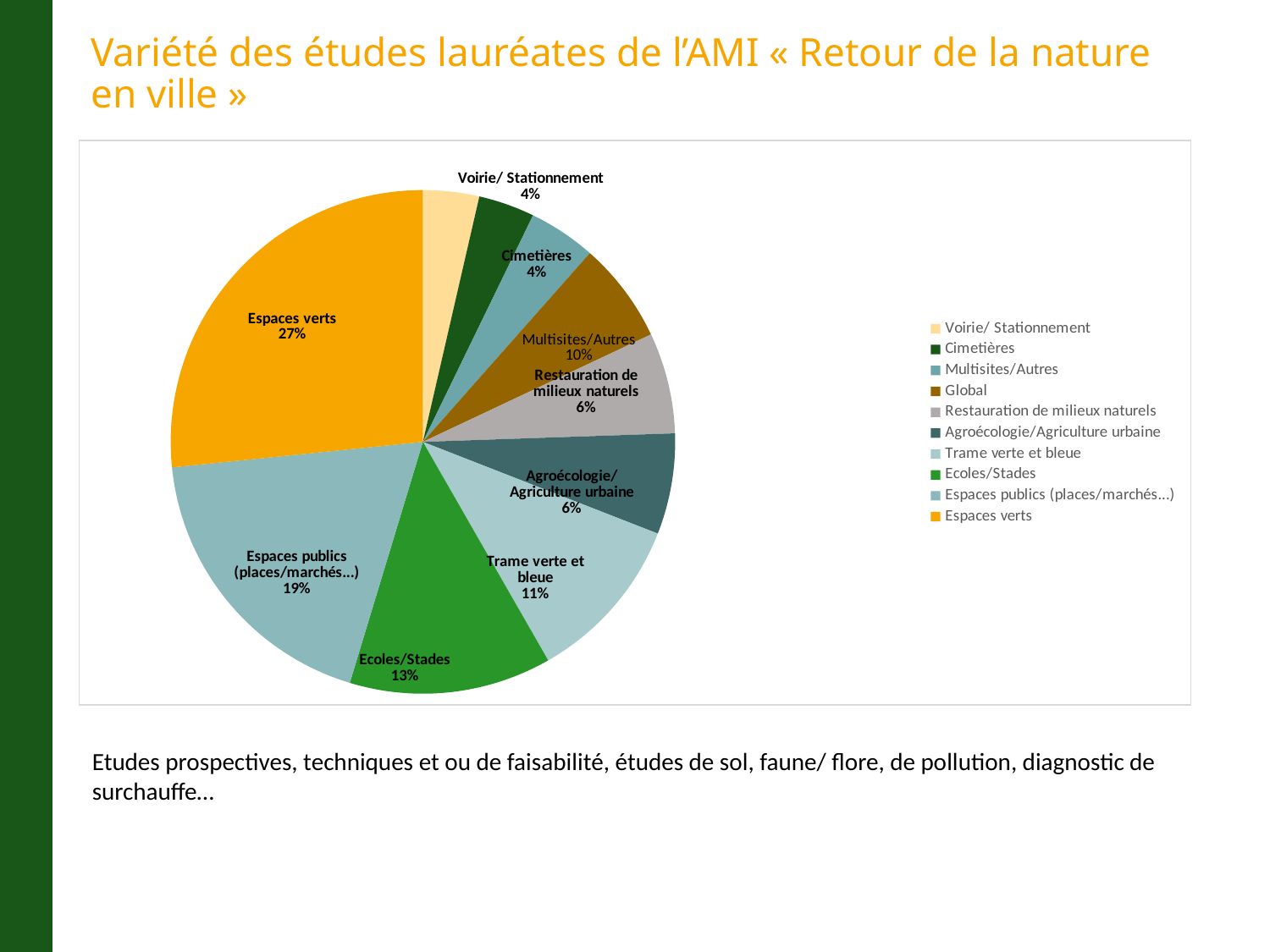
What percentage is shown for "Trame verte et bleue"? 11% What share of the pie does "Espaces verts" represent? 27% How many categories does the legend list? 10 What percentage is shown for "Cimetières"? 4% Which category has the largest share of the pie? Espaces verts What percentage is shown for "Espaces publics (places/marchés…)"? 19% What percentage is shown for "Ecoles/Stades"? 13% What percentage is shown for "Agroécologie/Agriculture urbaine"? 6% What colour is the "Espaces verts" slice? Orange By how many percentage points does "Espaces verts" exceed "Espaces publics (places/marchés…)"? 8 percentage points Which is larger, the share for "Ecoles/Stades" or for "Trame verte et bleue"? Ecoles/Stades What type of chart is shown on the slide? Pie chart